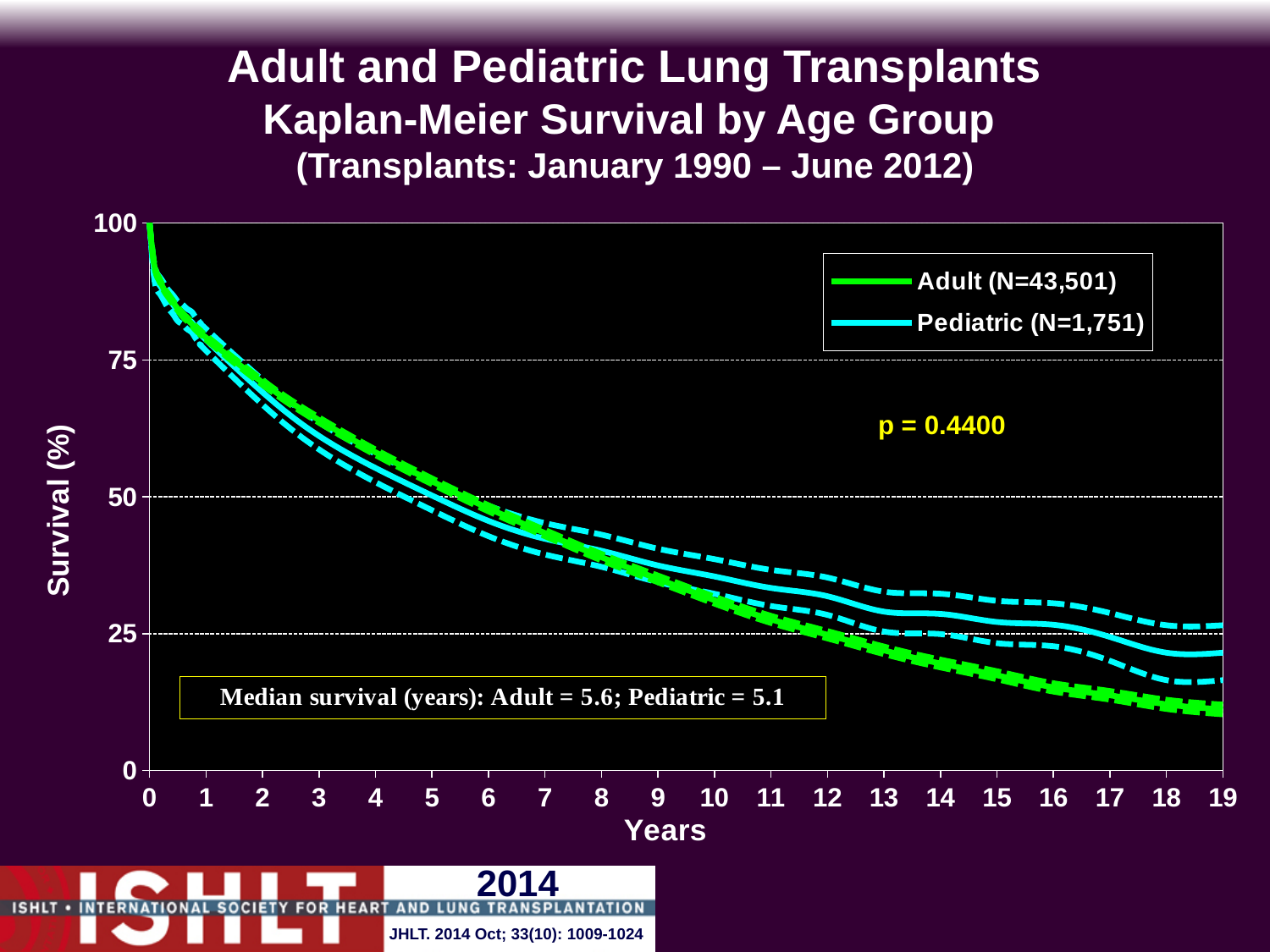
What is the sample size (N) for the Adult group? 43,501 What is the median survival in years for the Adult group? 5.6 What is the p-value shown on the chart? p = 0.4400 What kind of chart is shown on the slide? Line chart What is the median survival in years for the Pediatric group? 5.1 What is the sample size (N) for the Pediatric group? 1,751 Is the Adult survival value at 15 years greater or less than 25? less At 15 years, which curve shows higher survival, Adult or Pediatric? Pediatric Which group has the higher median survival, Adult or Pediatric? Adult How many series does the legend list? 2 What are the two series named in the legend? Adult (N=43,501) and Pediatric (N=1,751) Do the survival curves rise or fall as years increase? Fall